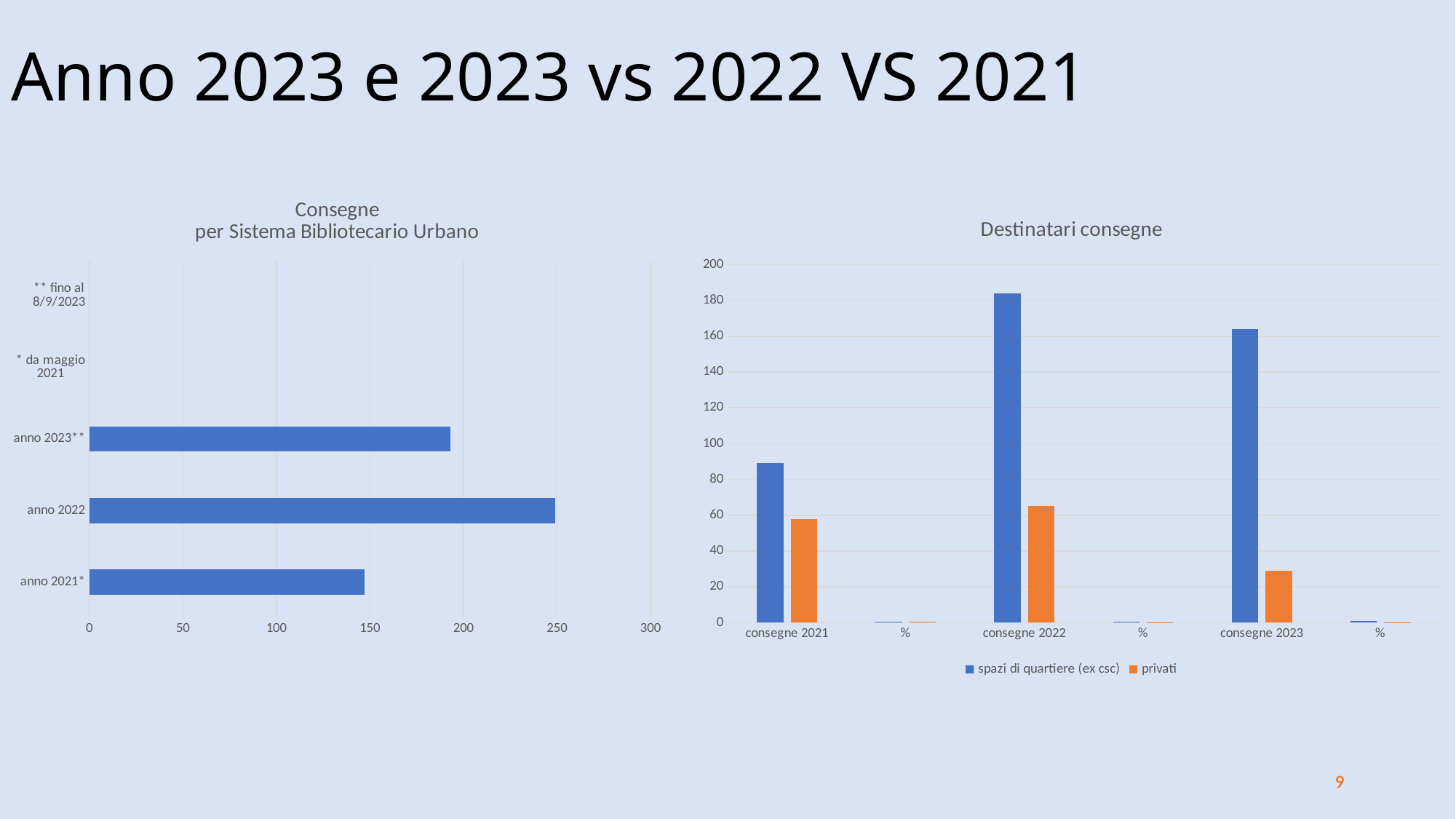
How many series does the legend of the chart titled "Destinatari consegne" list? 2 In the chart titled "Destinatari consegne", which category has the highest value for spazi di quartiere (ex csc)? consegne 2022 In the chart titled "Consegne per Sistema Bibliotecario Urbano", which year has the shortest bar? anno 2021* In the chart titled "Destinatari consegne", what colour are the bars for privati? orange In the chart titled "Consegne per Sistema Bibliotecario Urbano", which is larger, the value for anno 2023** or the value for anno 2021*? anno 2023** In the chart titled "Destinatari consegne", is the value for privati in consegne 2023 greater or less than 40? less In the chart titled "Consegne per Sistema Bibliotecario Urbano", is the value for anno 2022 greater or less than 200? greater What kind of chart is the chart titled "Consegne per Sistema Bibliotecario Urbano"? bar chart In the chart titled "Consegne per Sistema Bibliotecario Urbano", which year has the longest bar? anno 2022 In the chart titled "Destinatari consegne", which is larger in consegne 2021, spazi di quartiere (ex csc) or privati? spazi di quartiere (ex csc)